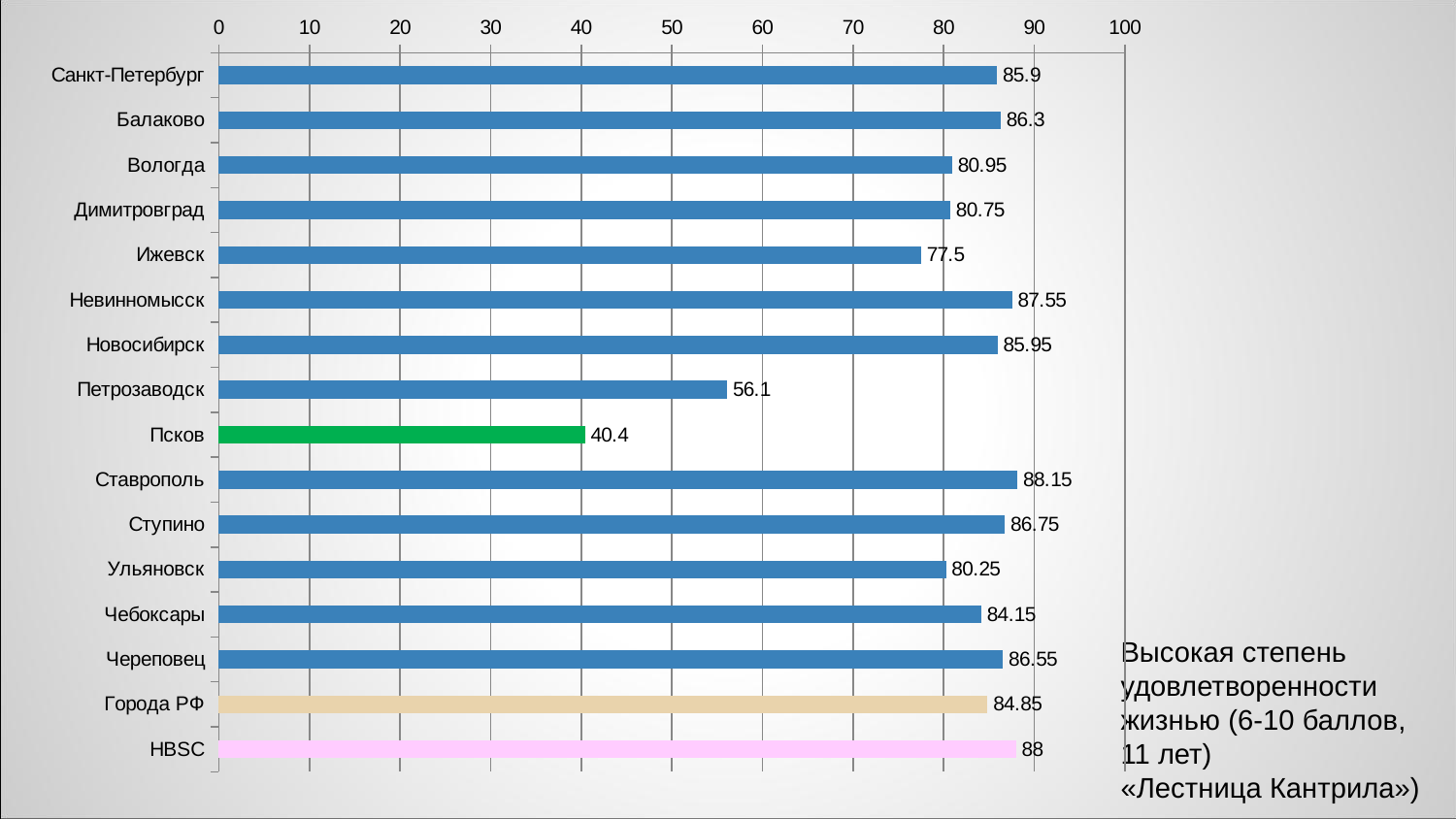
Which category has the highest value? Ставрополь Which category has the lowest value? Псков What is the value for HBSC? 88 What is the difference between the values for Петрозаводск and Псков? 15.7 How many categories are shown in the chart? 16 What kind of chart is shown on the slide? bar chart What colour is the bar for Псков? green Which is larger, the value for Ижевск or the value for Ульяновск? Ульяновск Is the value for Петрозаводск greater or less than 60? less What is the value for Невинномысск? 87.55 What is the value for Города РФ? 84.85 What is the value for Псков? 40.4